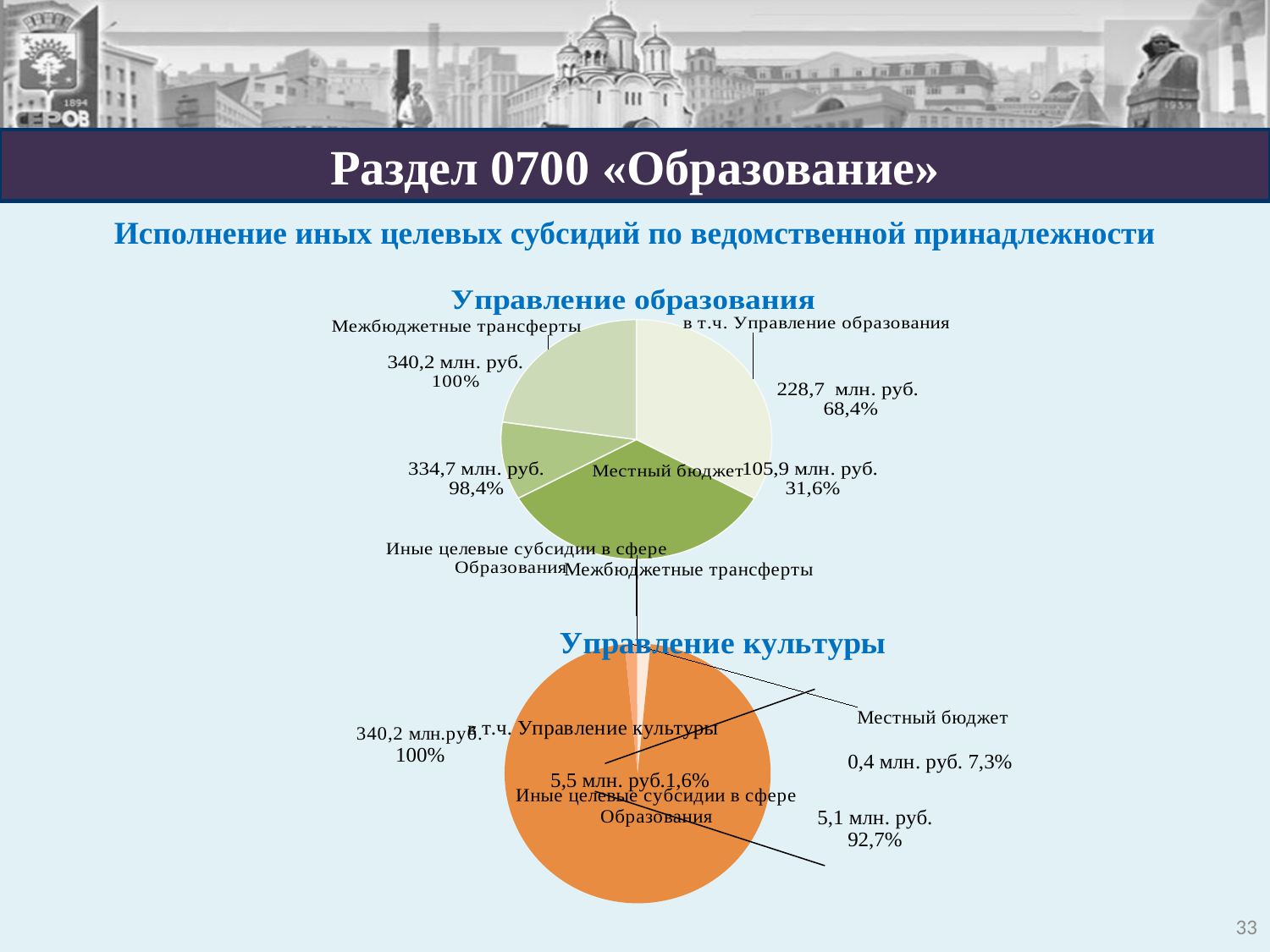
What kind of chart is used for «Управление образования»? pie chart In the «Управление культуры» chart, what percentage does the largest slice (5,1 млн. руб.) represent? 92,7% In the «Управление образования» chart, what percentage is shown for «в т.ч. Управление образования»? 68,4% In the «Управление образования» chart, what is the difference between 228,7 млн. руб. and 105,9 млн. руб.? 122,8 млн. руб. In the «Управление образования» chart, what value is shown for «в т.ч. Управление образования»? 228,7 млн. руб. In the «Управление образования» chart, which is larger: «в т.ч. Управление образования» (228,7 млн. руб.) or «Местный бюджет» (105,9 млн. руб.)? в т.ч. Управление образования What colour is the largest slice in the «Управление культуры» chart? orange What kind of chart is used for «Управление культуры»? pie chart How many charts are shown on the slide? 2 In the «Управление образования» chart, what percentage is shown for «Местный бюджет»? 31,6% In the «Управление образования» chart, what value is shown for «Местный бюджет»? 105,9 млн. руб.